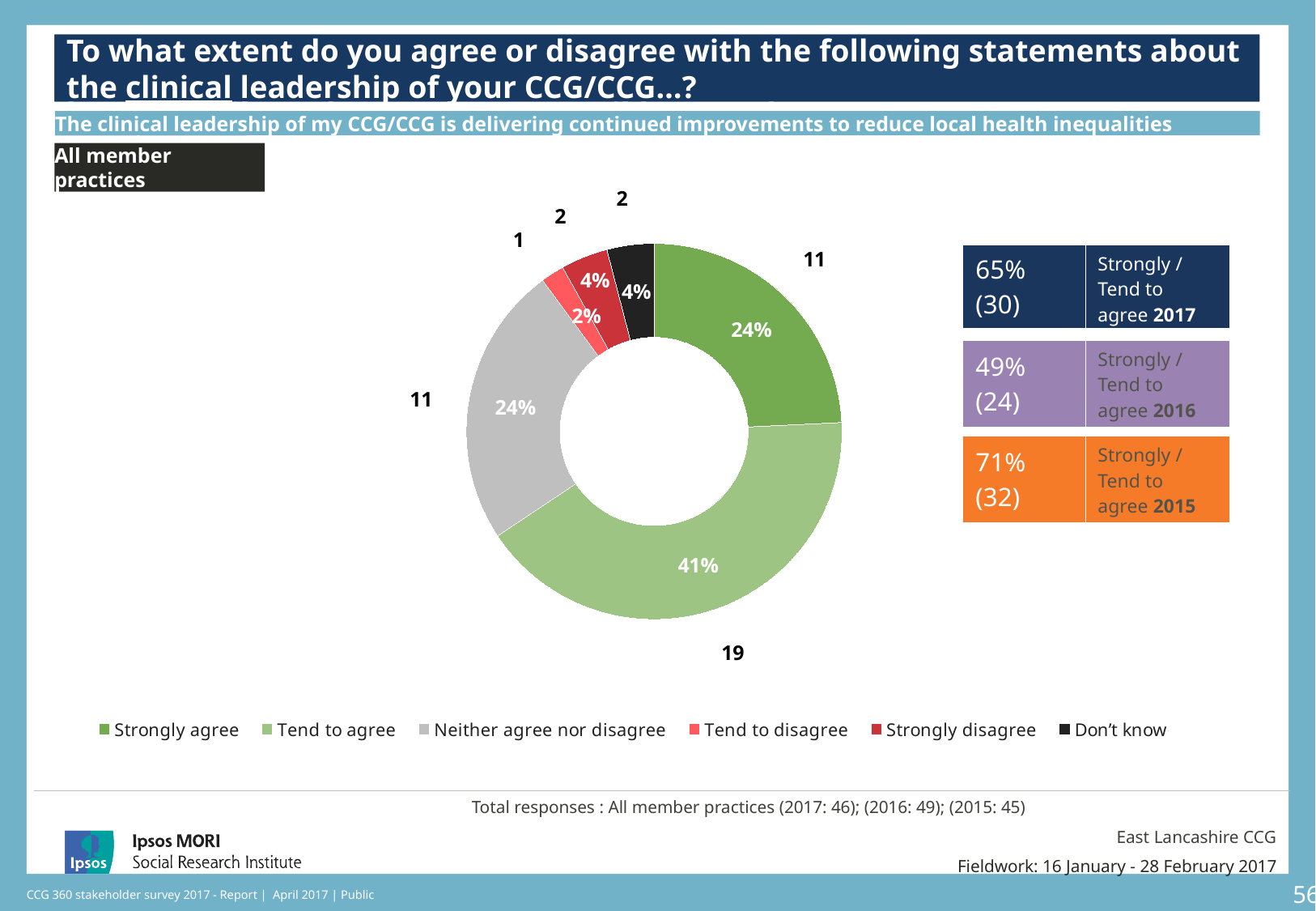
What percentage strongly or tended to agree in 2016? 49% What percentage of respondents said they tend to disagree? 2% What is the difference in percentage points between 'Tend to agree' and 'Strongly agree'? 17 How many respondents answered 'Don't know'? 2 How many response categories does the legend list? 6 What kind of chart is shown on the slide? Doughnut chart What colour represents 'Neither agree nor disagree' in the chart? Grey What percentage of respondents said they strongly agree? 24% Which response category has the smallest share of the chart? Tend to disagree Which response category has the largest share of the chart? Tend to agree Which is larger, the share for 'Strongly disagree' or the share for 'Tend to disagree'? Strongly disagree What percentage of respondents said they tend to agree? 41%